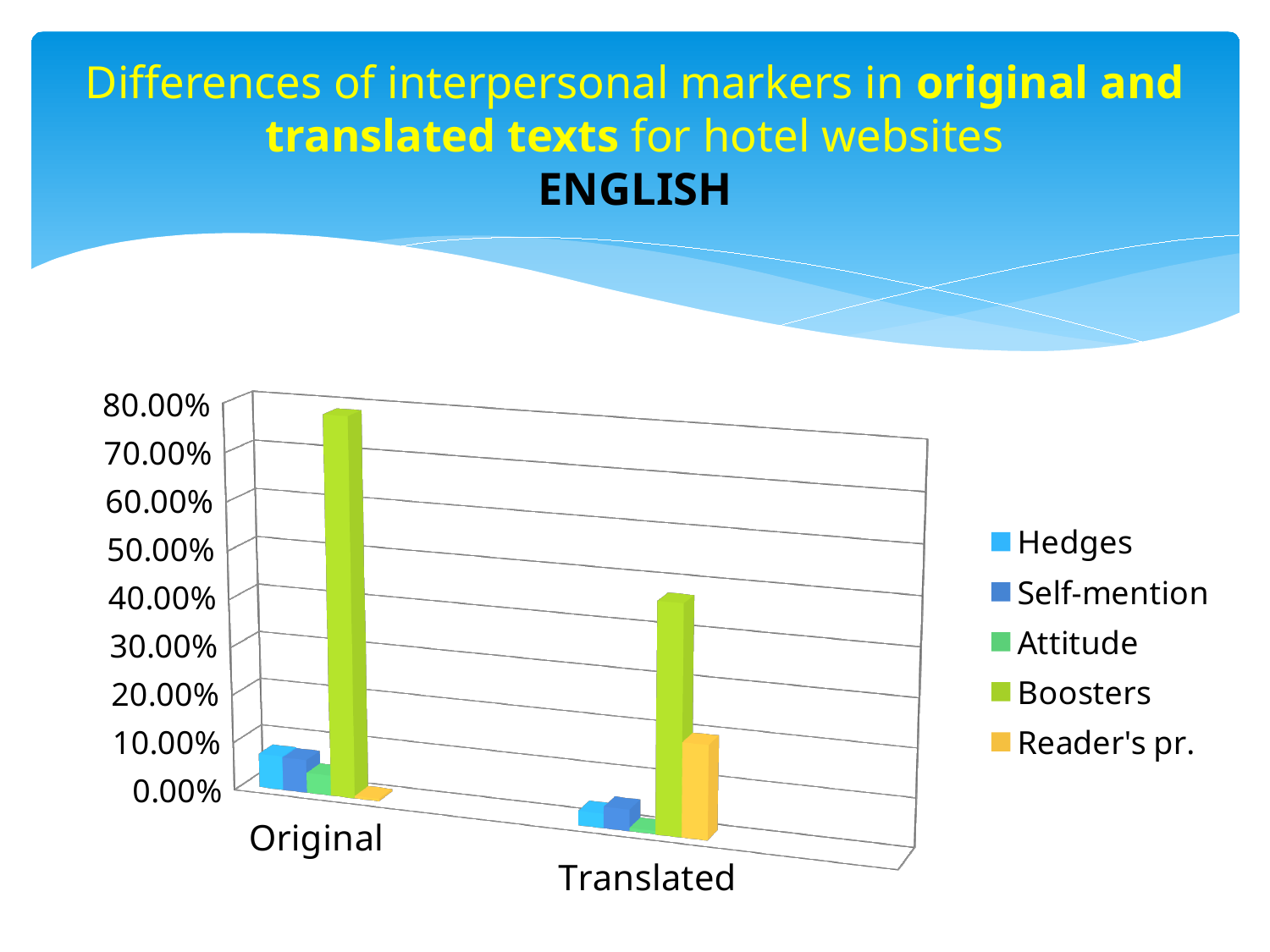
Which series has the highest value for the Translated category? Boosters How many categories are shown on the x axis of the chart? 2 Which category has the larger Boosters value, Original or Translated? Original How many series does the chart's legend list? 5 Is the Boosters value for Original greater or less than 70.00%? greater Which series has the highest value for the Original category? Boosters Is the Boosters value for Translated greater or less than 50.00%? less What kind of chart is shown on the slide? bar chart Which category has the larger Reader's pr. value, Original or Translated? Translated Which series has the lowest value for the Original category? Reader's pr.